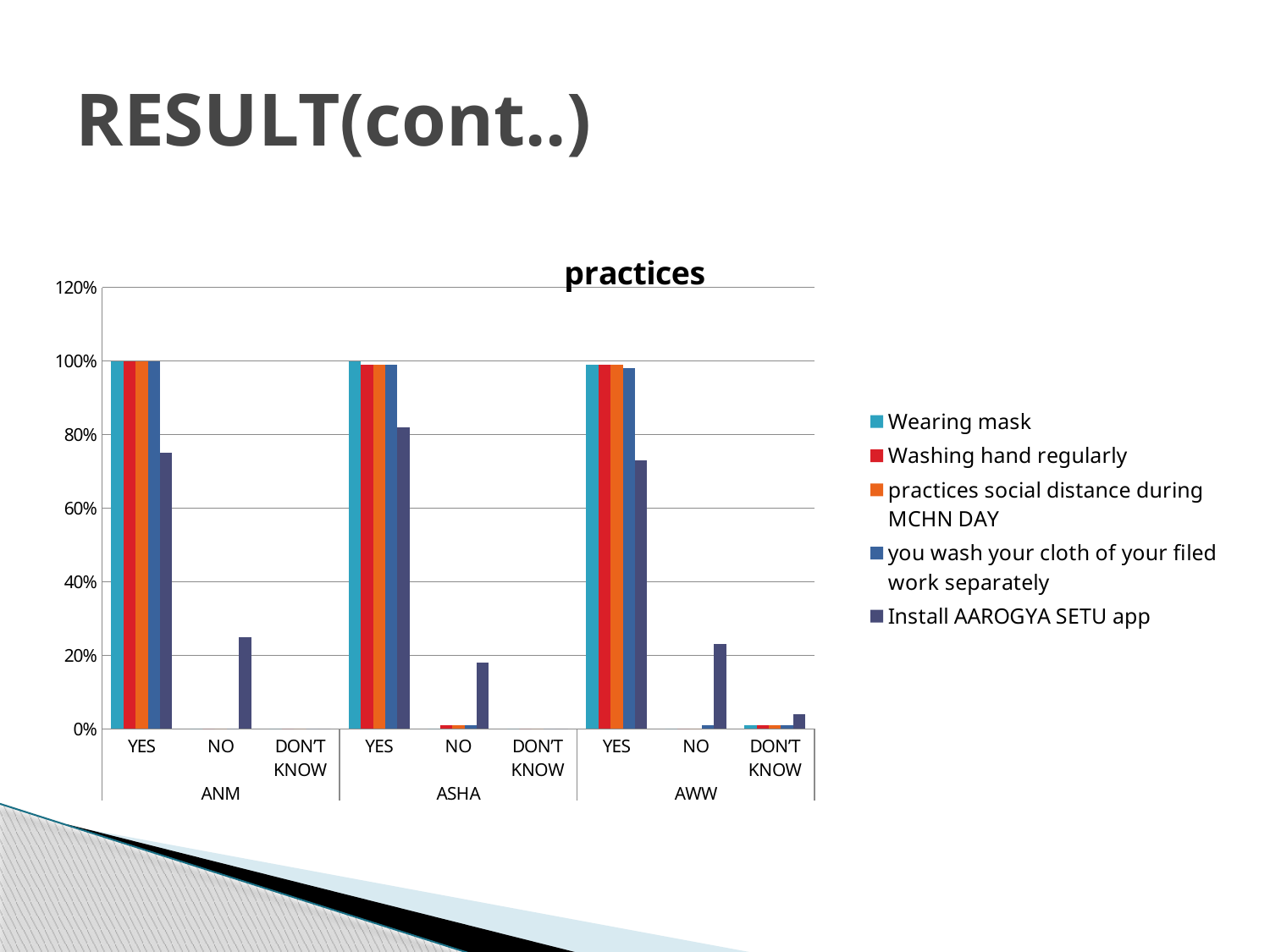
Is the value for Install AAROGYA SETU app under ANM YES greater or less than 60%? greater What is the value for Wearing mask under ANM YES? 100% Is the value for Install AAROGYA SETU app under AWW YES greater or less than 80%? less Is the value for Install AAROGYA SETU app under ANM NO greater or less than 40%? less What is the title of the chart? practices What is the value for Washing hand regularly under ANM YES? 100% How many worker groups (ANM, ASHA, AWW) are shown along the x axis? 3 How many series does the legend list? 5 For ANM, which is larger for Install AAROGYA SETU app: YES or NO? YES What type of chart is shown on the slide? bar chart For Install AAROGYA SETU app, which is larger: the YES value for ANM or the YES value for ASHA? ASHA